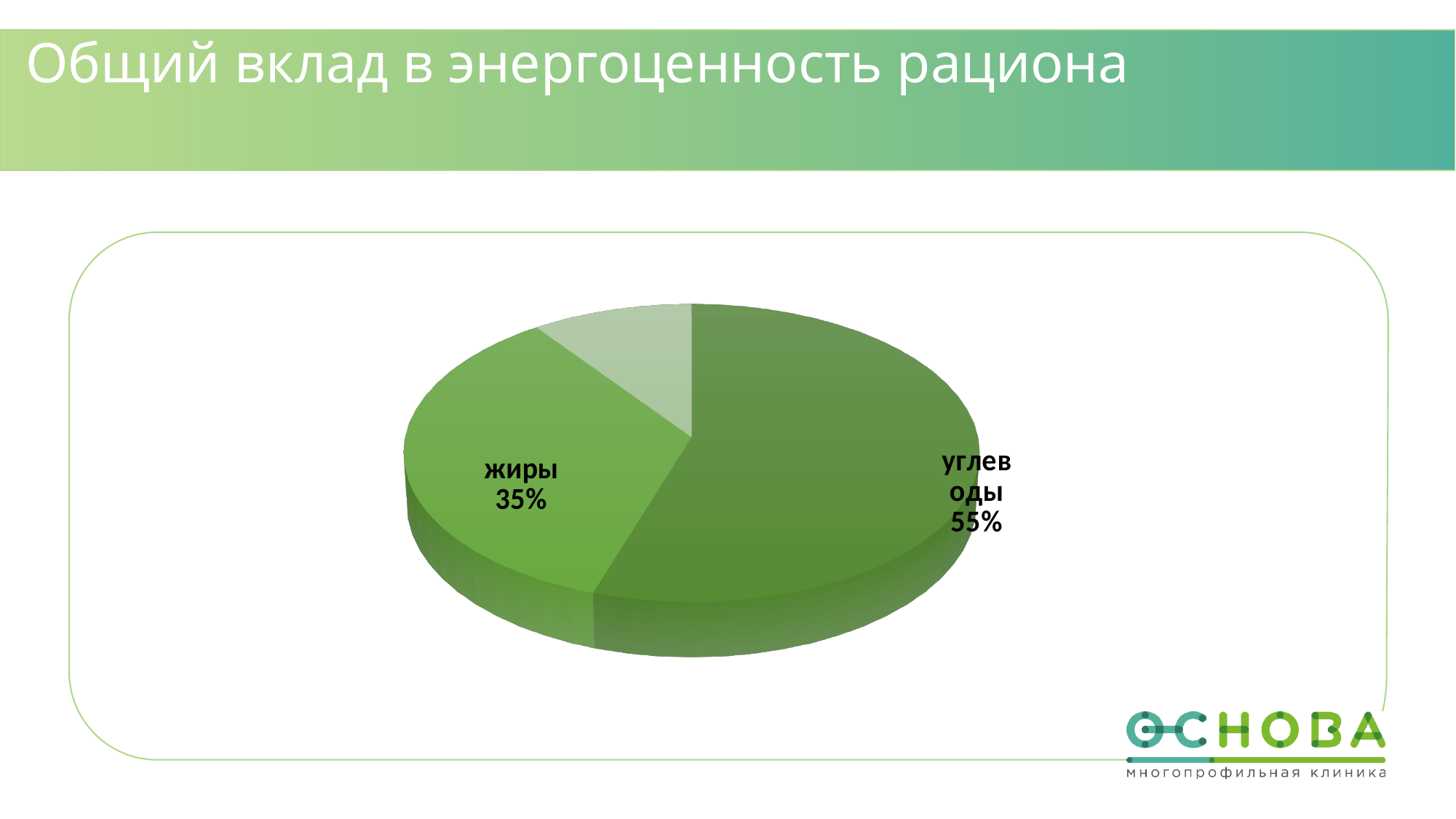
Which slice of the pie chart is the largest? углеводы By how many percentage points does углеводы exceed жиры? 20 percentage points What is the title of the slide? Общий вклад в энергоценность рациона How many slices does the pie chart have? 3 What kind of chart is shown on the slide? pie chart Which is larger, the share for жиры or the share for углеводы? углеводы What share of the pie does жиры represent? 35% What percentage is shown for углеводы in the pie chart? 55% Which of the two labeled slices, жиры or углеводы, is smaller? жиры Is the share for жиры greater or less than 50%? less Is the share for углеводы greater or less than 50%? greater What percentage is shown for жиры in the pie chart? 35%